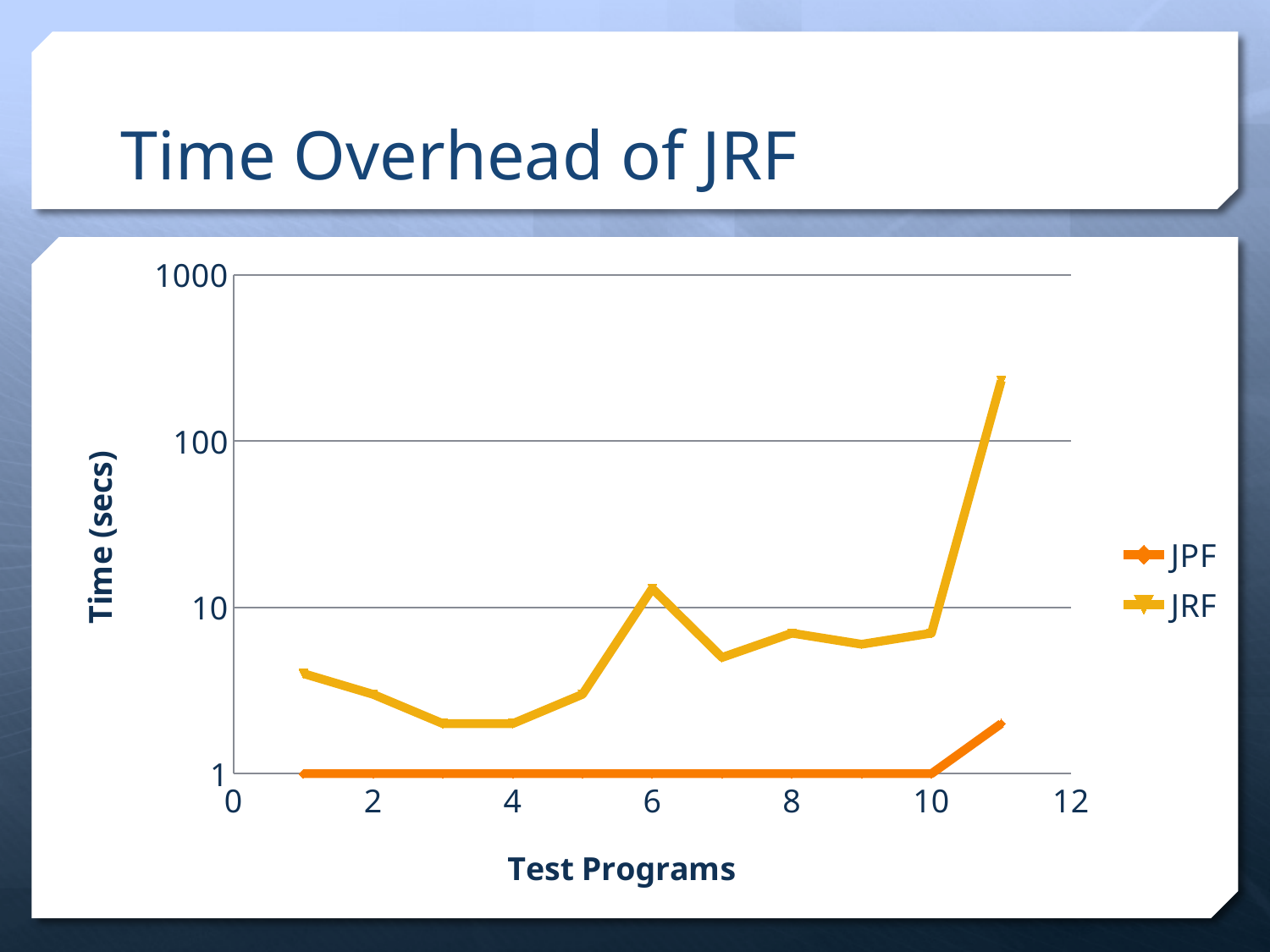
What is the JPF time in seconds for test program 5? 1 Is the JRF value for test program 11 greater or less than 100? greater At which test program does the JRF series reach its highest value? 11 Is the JRF value for test program 6 greater or less than 10? greater How many test programs are plotted for the JRF series? 11 Is the JRF value for test program 3 greater or less than 10? less Which series has the larger value at test program 6, JPF or JRF? JRF Does the JRF series rise or fall from test program 6 to test program 7? fall What is the title of the chart? Time Overhead of JRF How many series does the legend list? 2 What kind of chart is shown on the slide? line chart What is the label on the vertical axis? Time (secs)